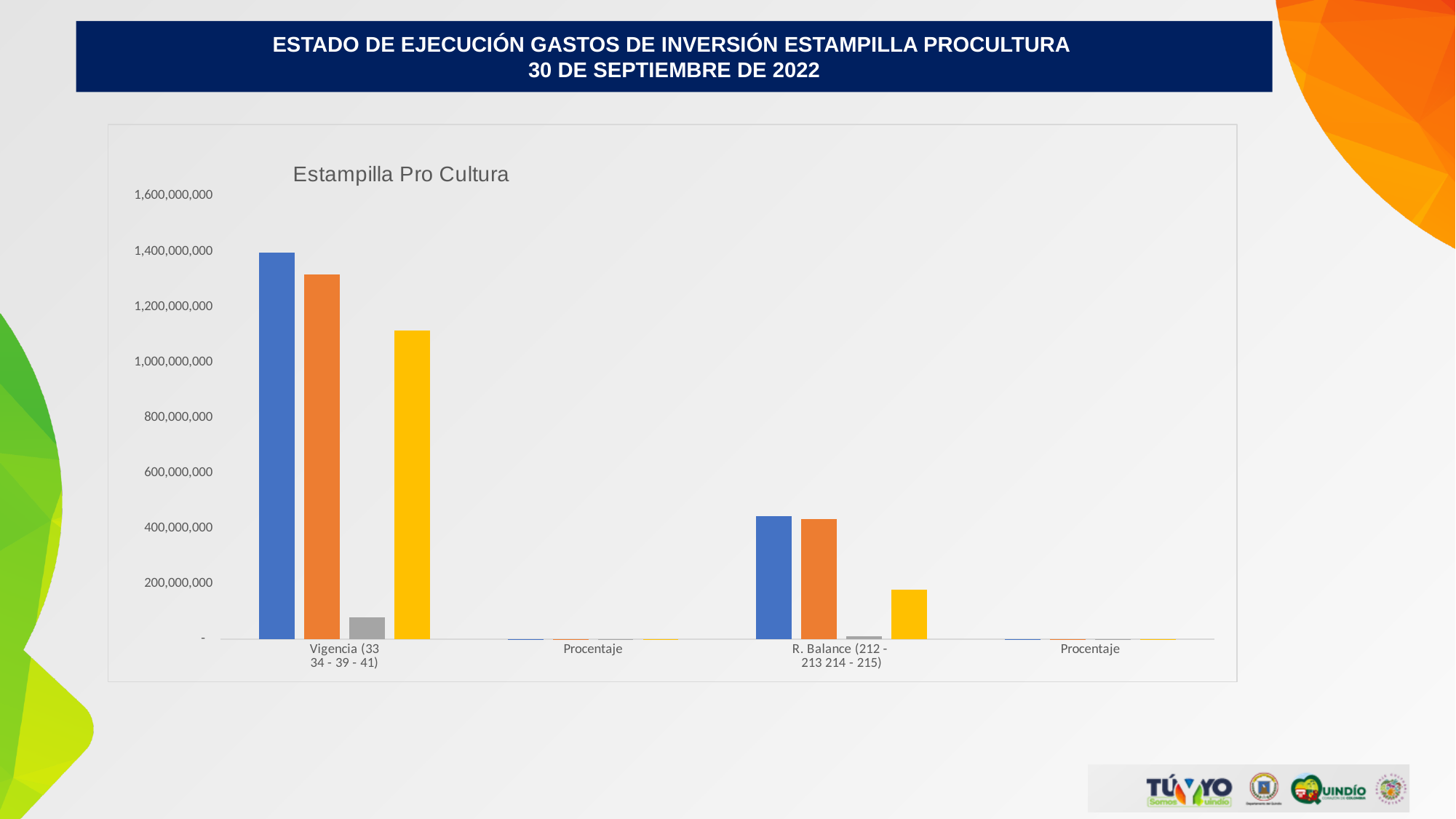
Is the value of the blue bar for Vigencia (33 34 - 39 - 41) greater or less than 1,200,000,000? greater What is the title of the chart? Estampilla Pro Cultura Within the R. Balance (212 - 213 214 - 215) category, which is larger: the orange bar or the yellow bar? The orange bar Which category has the tallest bar in the chart? Vigencia (33 34 - 39 - 41) Is the value of the gray bar for Vigencia (33 34 - 39 - 41) greater or less than 200,000,000? less How many bars are plotted for the Vigencia (33 34 - 39 - 41) category? 4 Is the value of the orange bar for R. Balance (212 - 213 214 - 215) greater or less than 200,000,000? greater How many categories are shown along the x axis of the chart? 4 What kind of chart is shown on the slide? Bar chart Which is larger: the blue bar for Vigencia (33 34 - 39 - 41) or the blue bar for R. Balance (212 - 213 214 - 215)? Vigencia (33 34 - 39 - 41)